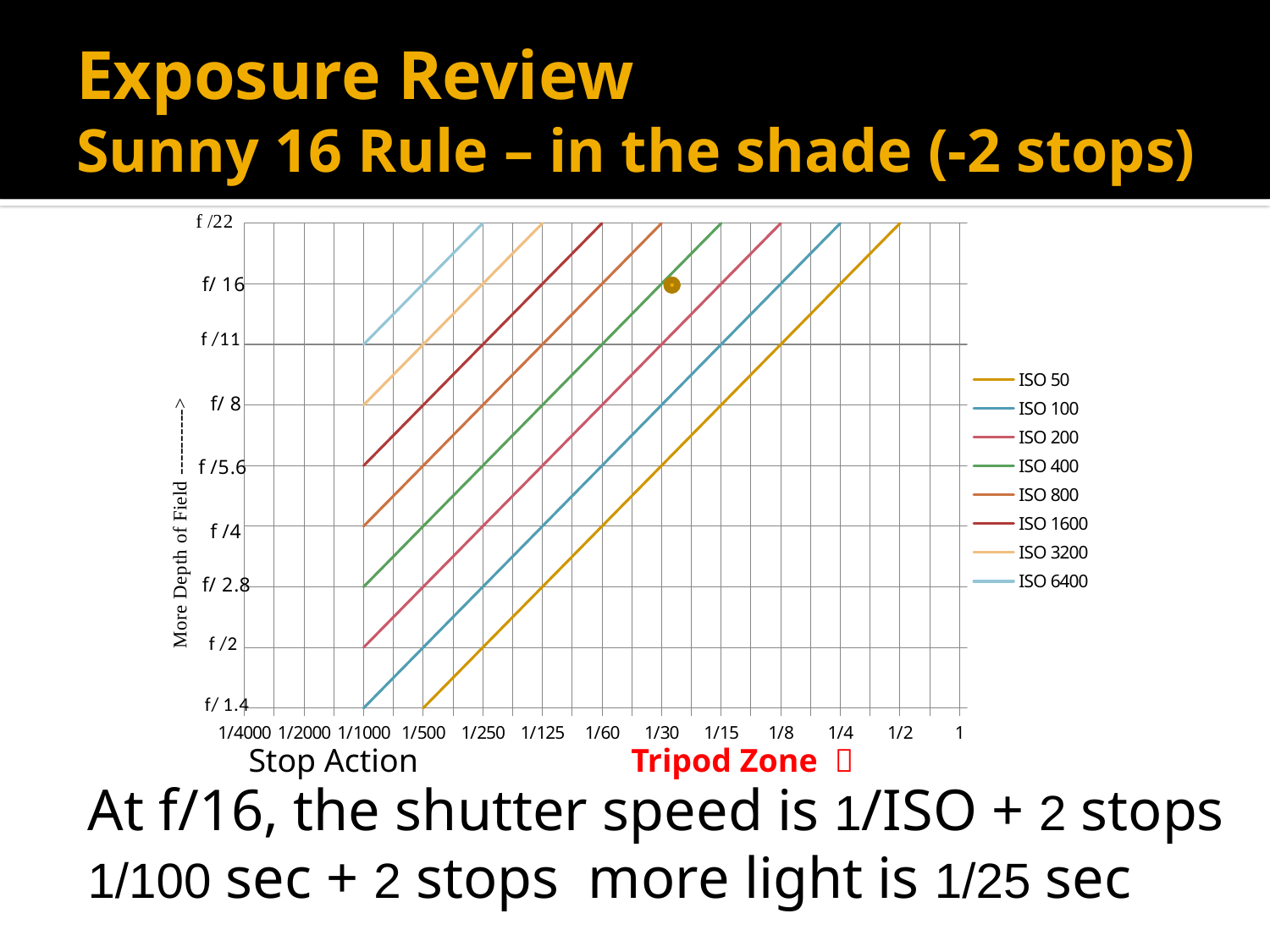
At which shutter speed does the ISO 50 line reach f/22? 1/2 How many shutter-speed categories are labelled along the x axis? 13 What kind of chart is shown on the slide? line chart Which series reaches f/22 at the slowest shutter speed (furthest right on the x axis)? ISO 50 Which series is listed first in the legend? ISO 50 At which shutter speed does the ISO 400 line reach f/22? 1/15 At which shutter speed does the ISO 6400 line reach f/22? 1/250 Do the ISO lines rise or fall as the shutter speed moves from 1/4000 toward 1 along the x axis? rise At which shutter speed does the ISO 100 line reach f/16? 1/8 How many series does the chart's legend list? 8 What is the label on the vertical axis of the chart? More Depth of Field Which series reaches f/22 at the fastest shutter speed (furthest left on the x axis)? ISO 6400